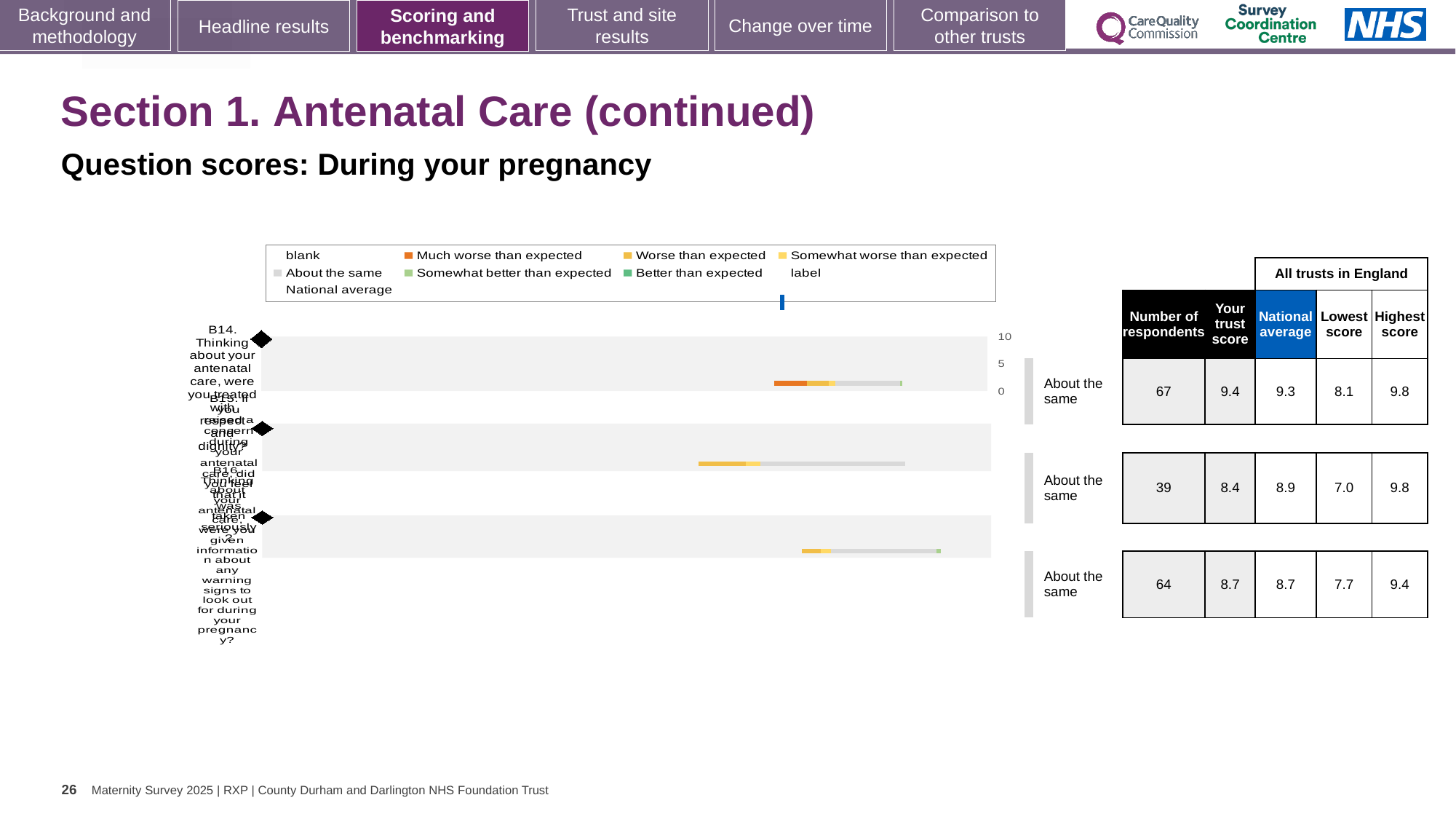
What is the 'Number of respondents' for the third question row (B16)? 64 How many question rows are plotted in the chart? 3 What kind of chart is shown on the slide? bar chart Is the 'Your trust score' for the first question row (B14) larger or smaller than its 'National average'? larger Which question row has the lowest 'Your trust score'? B15 (second row) What is the difference between the 'Highest score' and 'Lowest score' for the second question row (B15)? 2.8 What is the 'Your trust score' for the first question row (B14)? 9.4 Which question row has the highest 'Number of respondents'? B14 (first row) What is the highest value shown on the chart's axis? 10 What benchmark category is shown for all three question rows? About the same How many entries does the chart legend list? 9 What is the 'National average' for the second question row (B15)? 8.9